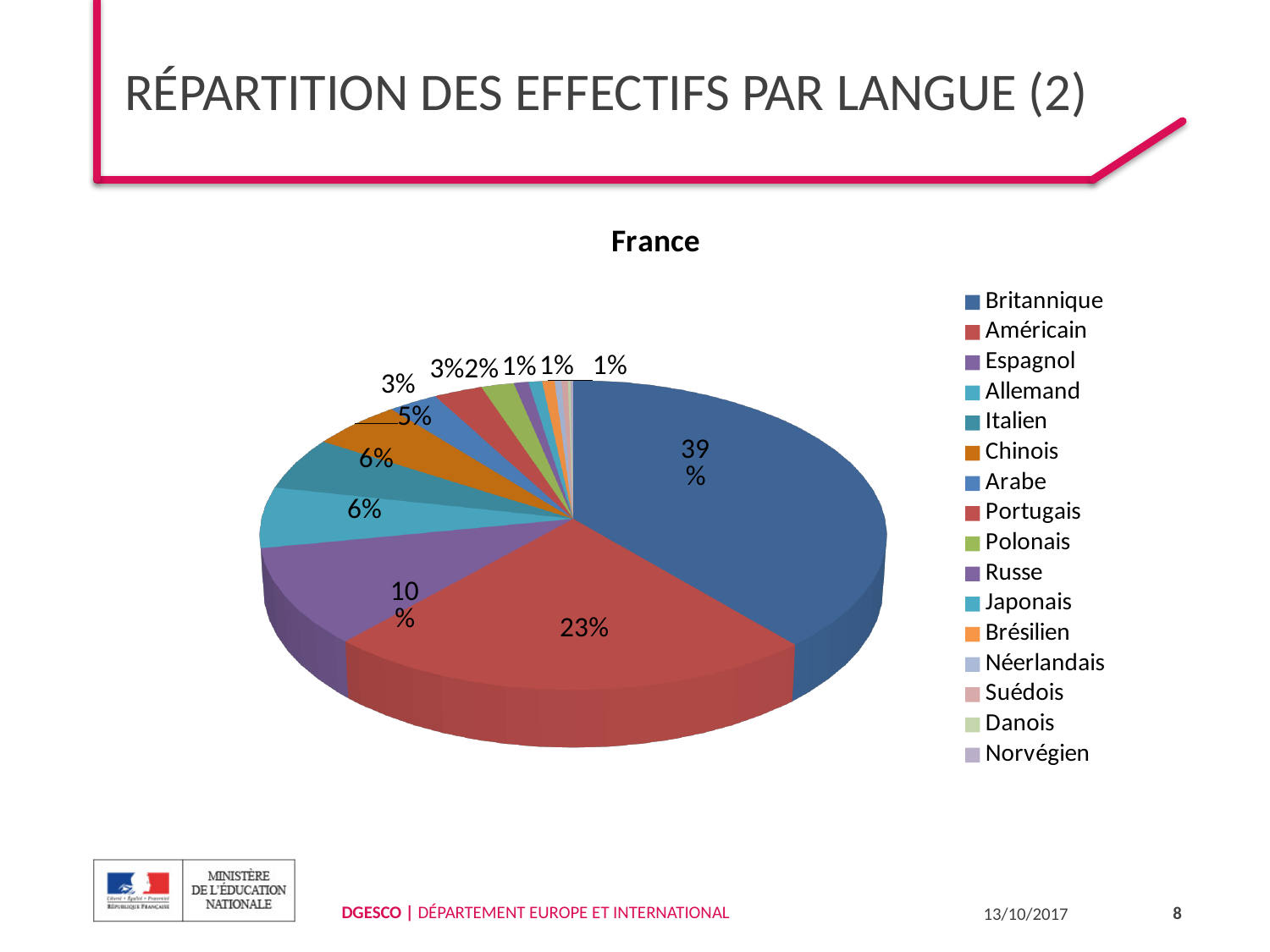
What share of the pie does Britannique represent? 39% What share of the pie does Américain represent? 23% What colour is the Britannique slice? Blue What share of the pie does Chinois represent? 5% Which slice is larger, Espagnol or Chinois? Espagnol Which language has the largest slice of the pie? Britannique What share of the pie does Espagnol represent? 10% What is the combined share of the Britannique and Américain slices? 62% What is the title of the chart? France What is the difference in percentage points between the Britannique and Américain slices? 16 What kind of chart is shown on the slide? Pie chart How many languages are listed in the legend? 16